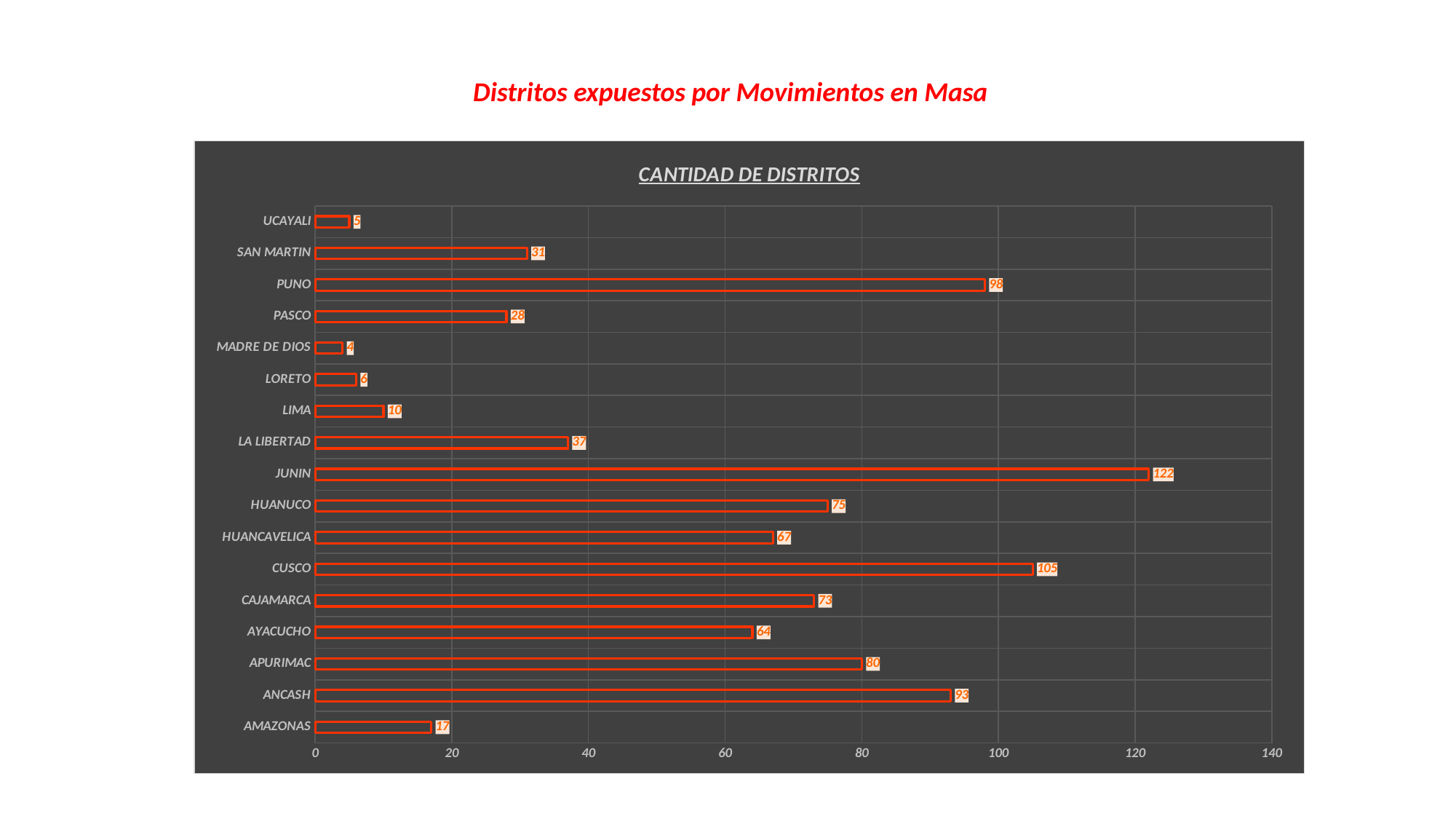
What is the value for LA LIBERTAD? 37 What is the value for CUSCO? 105 Which region has the lowest number of districts? MADRE DE DIOS Is the value for APURIMAC greater or less than 60? greater Which is larger, the value for HUANUCO or the value for CAJAMARCA? HUANUCO What is the difference between the values for PUNO and ANCASH? 5 How many regions are shown on the chart? 17 What is the value for JUNIN? 122 What is the value for MADRE DE DIOS? 4 What kind of chart is shown on the slide? bar chart Which region has the highest number of districts? JUNIN What is the title of the chart? CANTIDAD DE DISTRITOS